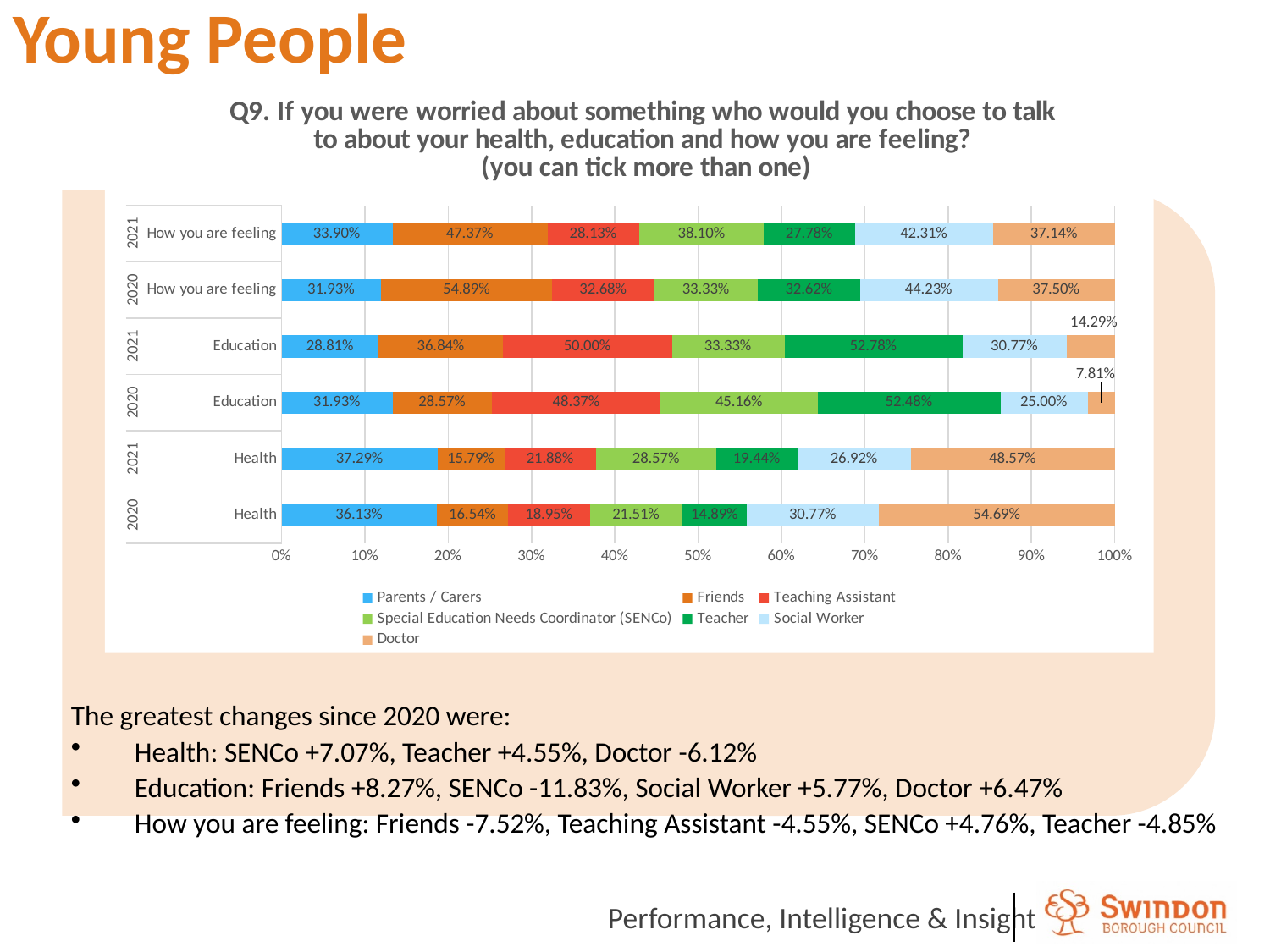
What is the value for Friends in the How you are feeling 2020 bar? 54.89% What is the value for Doctor in the Health 2020 bar? 54.69% How many series does the legend list? 7 What is the value for Doctor in the Education 2021 bar? 14.29% Which legend entry is shown in light blue? Social Worker Which is larger: Friends in How you are feeling 2020 or Friends in How you are feeling 2021? How you are feeling 2020 What is the value for Teacher in the Education 2020 bar? 52.48% What kind of chart is shown on the slide? Stacked bar chart What is the difference between the Doctor values for Health 2020 and Health 2021? 6.12% Which series has the lowest labelled value in the Education 2020 bar? Doctor How many bars are plotted in the chart? 6 Which series has the highest labelled value in the Health 2021 bar? Doctor